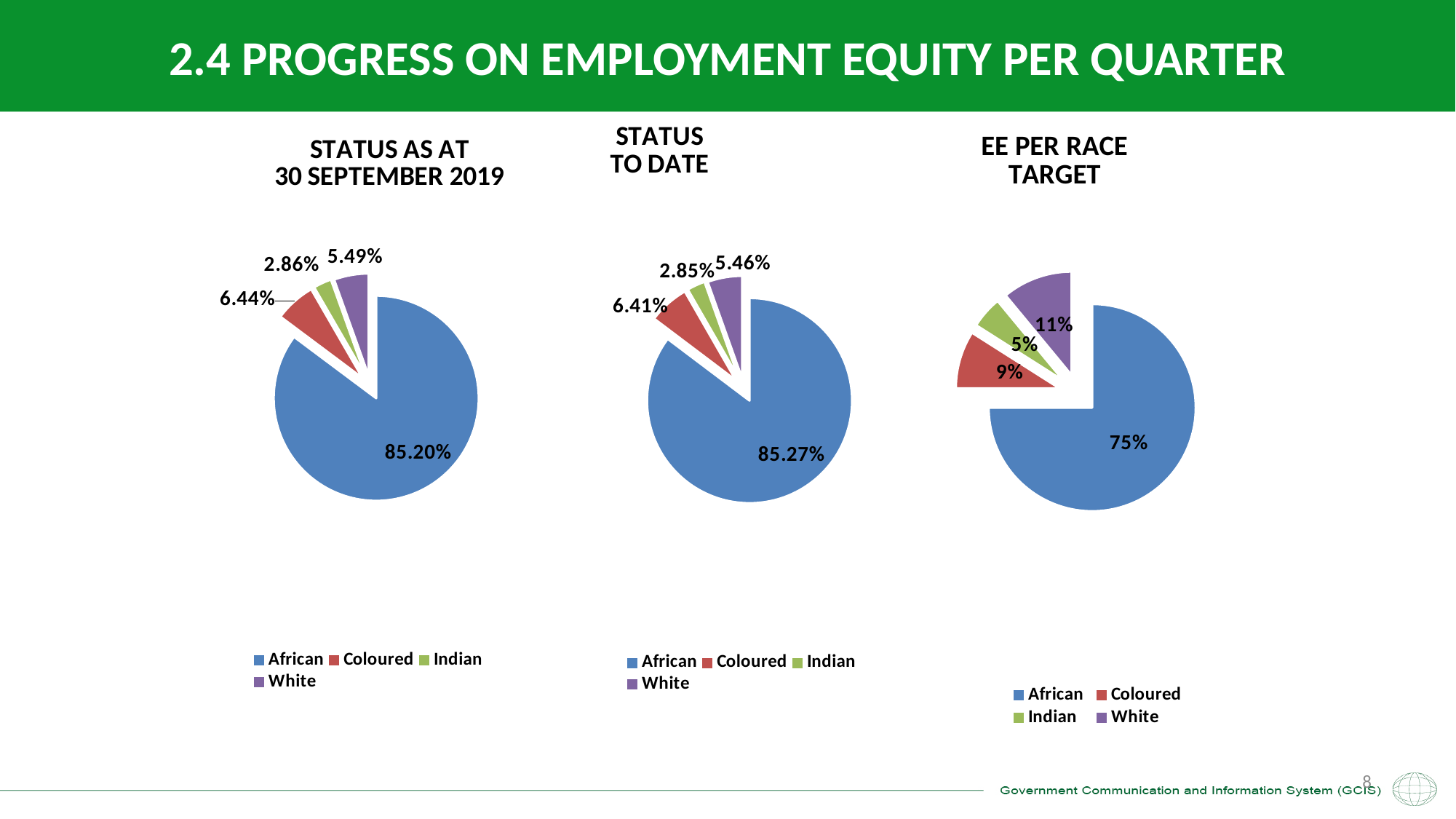
In the 'EE PER RACE TARGET' chart, what is the difference between the White and Indian values? 6% In the 'STATUS AS AT 30 SEPTEMBER 2019' chart, which category has the smallest share? Indian In the 'STATUS AS AT 30 SEPTEMBER 2019' chart, what is the value for Coloured? 6.44% In the 'STATUS TO DATE' chart, what is the value for White? 5.46% How many categories does the 'EE PER RACE TARGET' chart show? 4 What kind of chart is the 'STATUS TO DATE' chart? Pie chart In the 'EE PER RACE TARGET' chart, what is the value for Coloured? 9% In the 'STATUS TO DATE' chart, what is the value for Indian? 2.85% How many charts are shown on the slide? 3 In the 'STATUS AS AT 30 SEPTEMBER 2019' chart, what is the value for African? 85.20% In the 'STATUS TO DATE' chart, which is larger, Coloured or White? Coloured In the 'EE PER RACE TARGET' chart, which category has the largest share? African